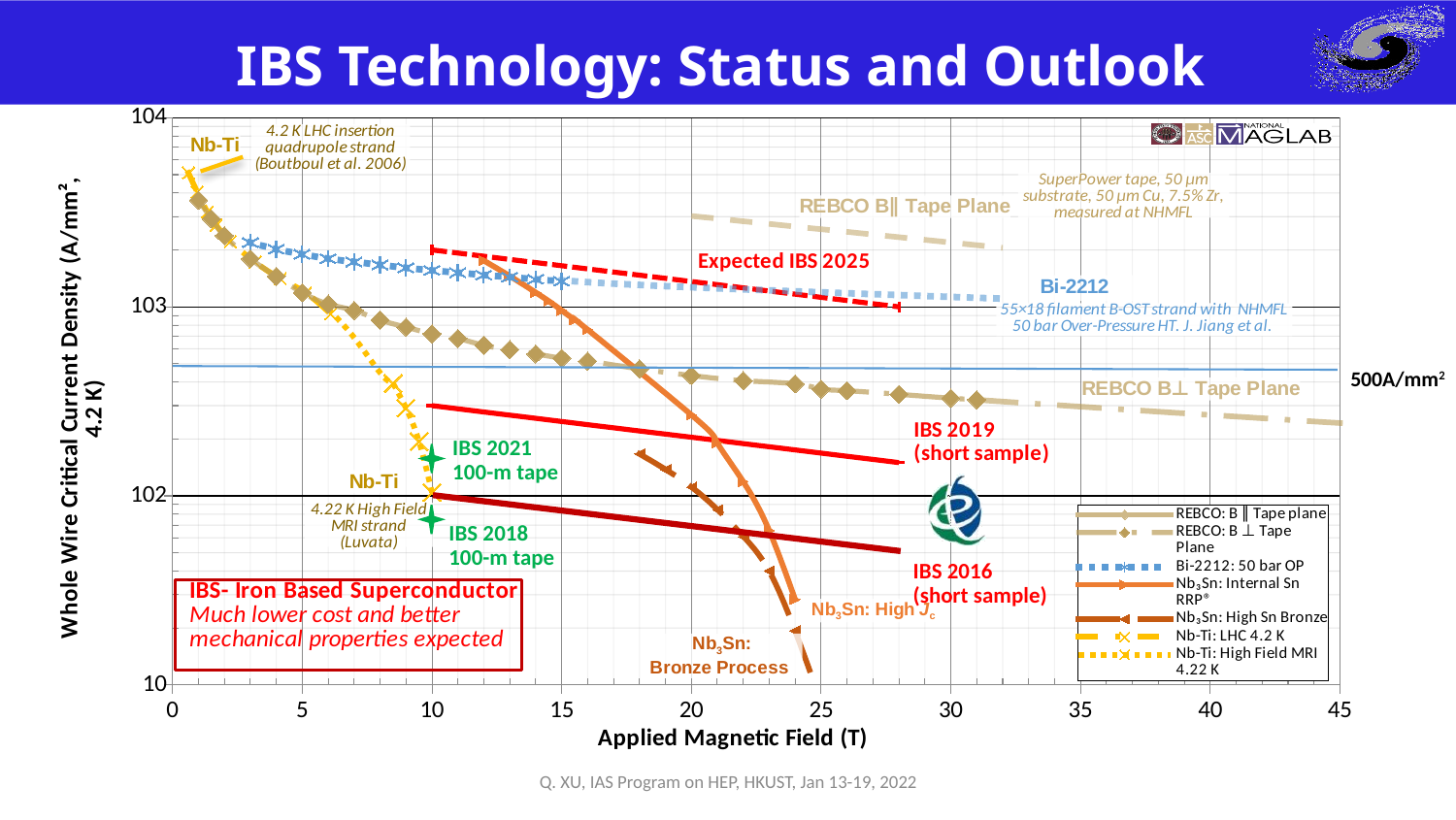
What value is labelled on the horizontal reference line at the right of the chart? 500A/mm² Is the value of the Nb-Ti LHC 4.2 K curve at 9 T greater or less than 103? less Which IBS curve is plotted lowest on the chart? IBS 2016 (short sample) Is the value of the IBS 2016 (short sample) curve at 25 T greater or less than 102? less What is the label of the x axis? Applied Magnetic Field (T) How many series does the legend list? 7 At 20 T, which is higher: the REBCO B∥ Tape Plane curve or the Nb3Sn Bronze Process curve? REBCO B∥ Tape Plane What is the highest value shown on the x axis? 45 Is the value of the REBCO B∥ Tape Plane curve at 30 T greater or less than 103? greater Do the Nb3Sn curves rise or fall as the applied magnetic field increases? Fall What kind of chart is shown on the slide? Line chart Which IBS curve is plotted highest on the chart? Expected IBS 2025